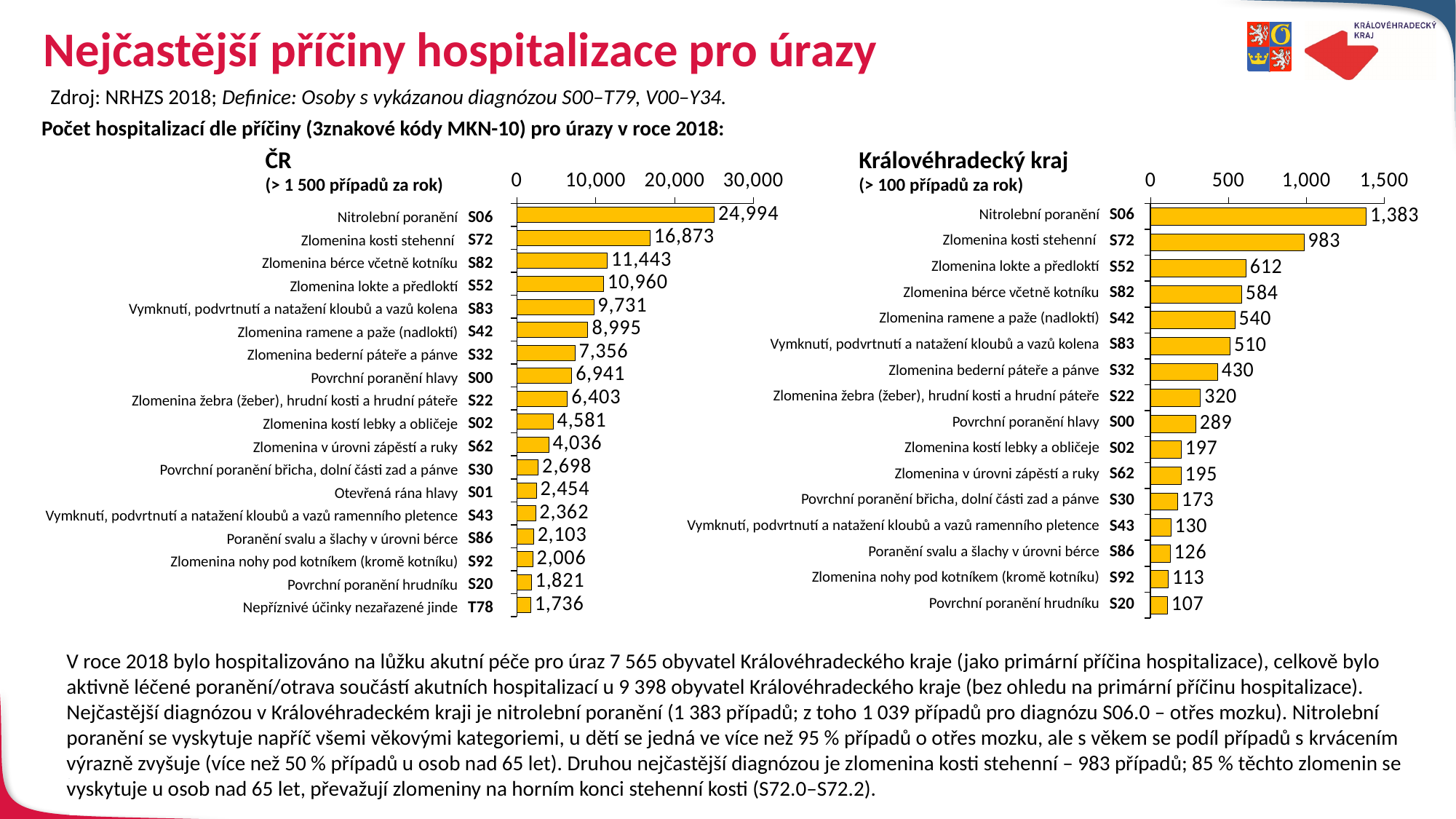
What type of chart is used for the Královéhradecký kraj data? Bar chart In the Královéhradecký kraj chart, what is the value for Zlomenina kosti stehenní (S72)? 983 In the Královéhradecký kraj chart, is the value for S32 greater or less than 500? less How many categories are shown in the Královéhradecký kraj chart? 16 In the ČR chart, how many hospitalizations are shown for Nitrolební poranění (S06)? 24,994 How many categories are shown in the ČR chart? 18 In the ČR chart, which category has the lowest value? Nepříznivé účinky nezařazené jinde (T78) In the ČR chart, which is larger: the value for S82 or the value for S52? S82 In the Královéhradecký kraj chart, what is the difference between the values for S52 and S82? 28 What is the maximum value shown on the x axis of the ČR chart? 30,000 In the ČR chart, what is the difference between the values for S06 and S72? 8,121 In the Královéhradecký kraj chart, which category has the highest value? Nitrolební poranění (S06)